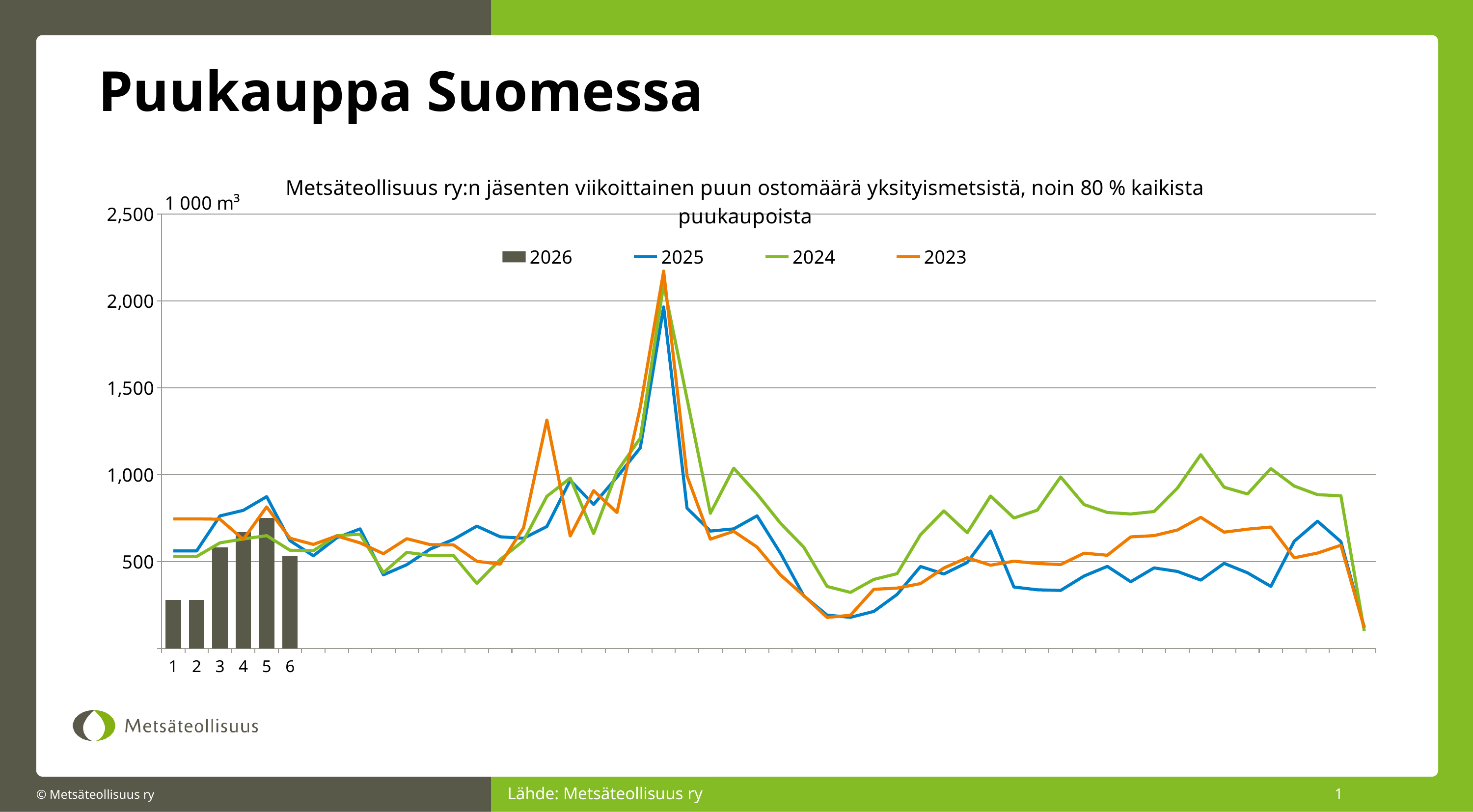
What kind of chart is shown on the slide? A combined bar and line chart Is the 2026 bar for week 5 greater or less than 500? greater Which week has the highest 2026 bar? 5 Is the 2026 bar for week 1 greater or less than 500? less Do the 2026 bars rise or fall from week 1 to week 5? rise How many series does the chart legend list? 4 What unit is shown on the vertical axis of the chart? 1 000 m³ Which is larger, the 2026 bar for week 4 or the 2026 bar for week 6? Week 4 Which series is drawn as bars rather than a line? 2026 Which series reaches the highest value on the chart? 2023 Is the highest point of the 2023 line greater or less than 2,000? greater How many bars are plotted for the 2026 series? 6